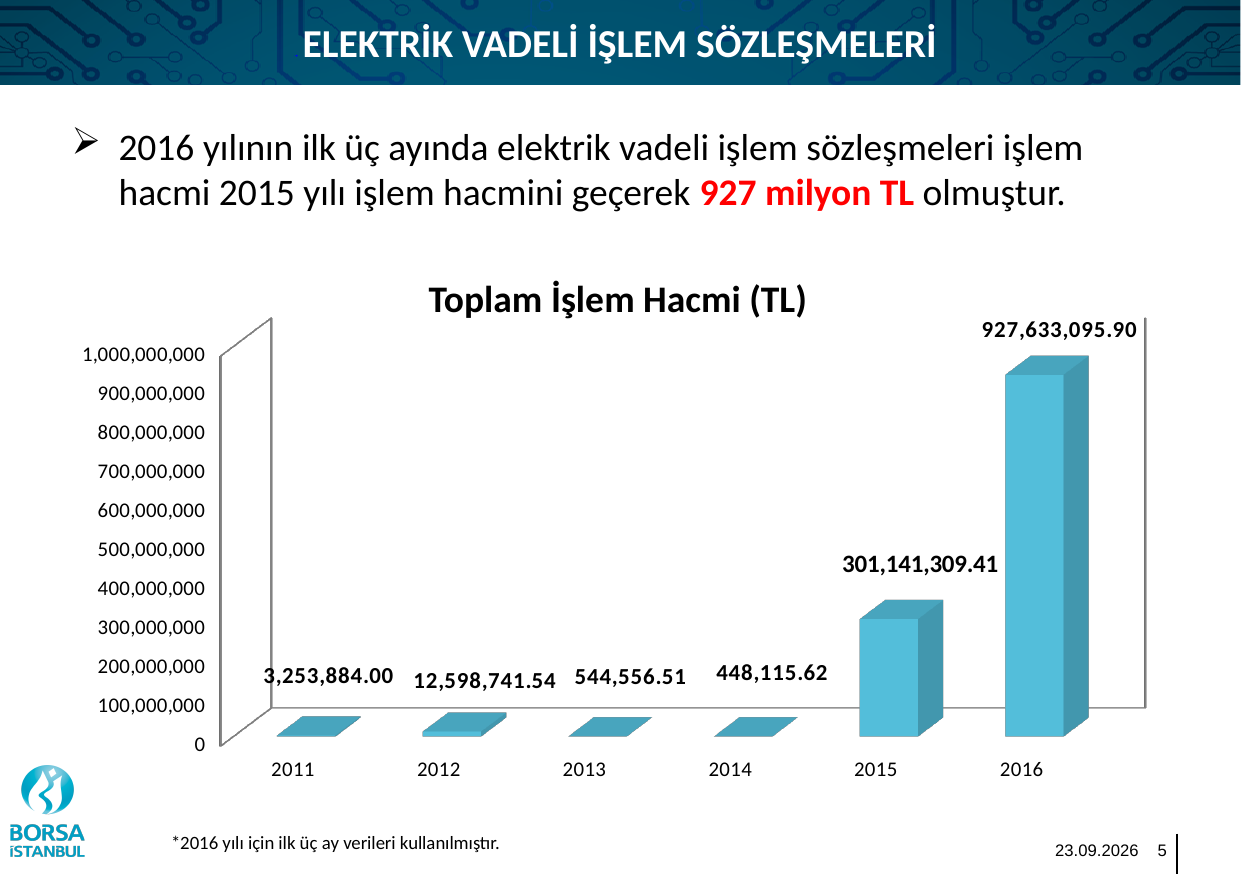
Which year has the lowest total transaction volume in the chart? 2014 Which year has the highest total transaction volume in the chart? 2016 What type of chart is shown on the slide? Bar chart What is the value for 2011 in the Toplam İşlem Hacmi (TL) chart? 3,253,884.00 What is the value for 2016 in the Toplam İşlem Hacmi (TL) chart? 927,633,095.90 Is the value for 2016 greater or less than 900,000,000? greater What is the value for 2013 in the Toplam İşlem Hacmi (TL) chart? 544,556.51 Which is larger in the chart, the value for 2012 or the value for 2013? 2012 What is the value for 2015 in the Toplam İşlem Hacmi (TL) chart? 301,141,309.41 What is the difference between the 2012 and 2011 values in the chart? 9,344,857.54 What is the difference between the 2016 and 2015 values in the chart? 626,491,786.49 How many years are shown on the x axis of the chart? 6